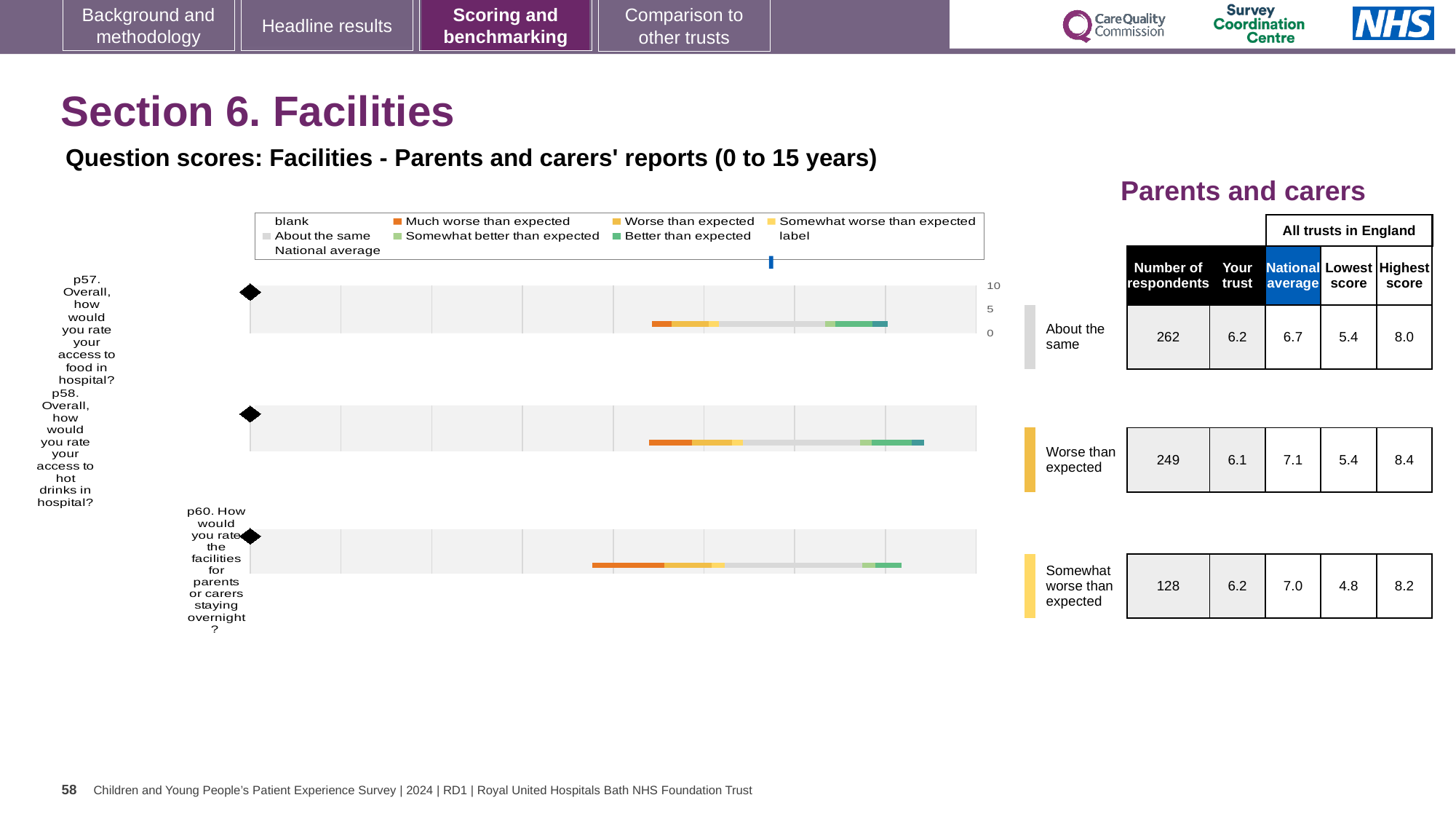
How many survey questions (bars) are plotted in the Facilities chart? 3 Which legend entry is shown in orange in the Facilities chart? Much worse than expected According to the table beside the chart, how many respondents answered p60 (facilities for parents or carers staying overnight)? 128 What is the difference between the national average and the trust score for p58 (access to hot drinks)? 1.0 Which of the three questions has the lowest 'Lowest score' across all trusts in England? p60 What is the highest value shown on the chart's score axis? 10 Which of the three questions has the highest 'Highest score' across all trusts in England? p58 According to the table beside the chart, what is the national average for p58 (access to hot drinks in hospital)? 7.1 What kind of chart is used to show the question scores for Facilities? bar chart According to the table beside the chart, what is the 'Your trust' score for p57 (access to food in hospital)? 6.2 Which benchmark category is the trust's p58 (access to hot drinks) score placed in? Worse than expected Is the trust score for p57 (access to food) larger or smaller than the national average for that question? smaller